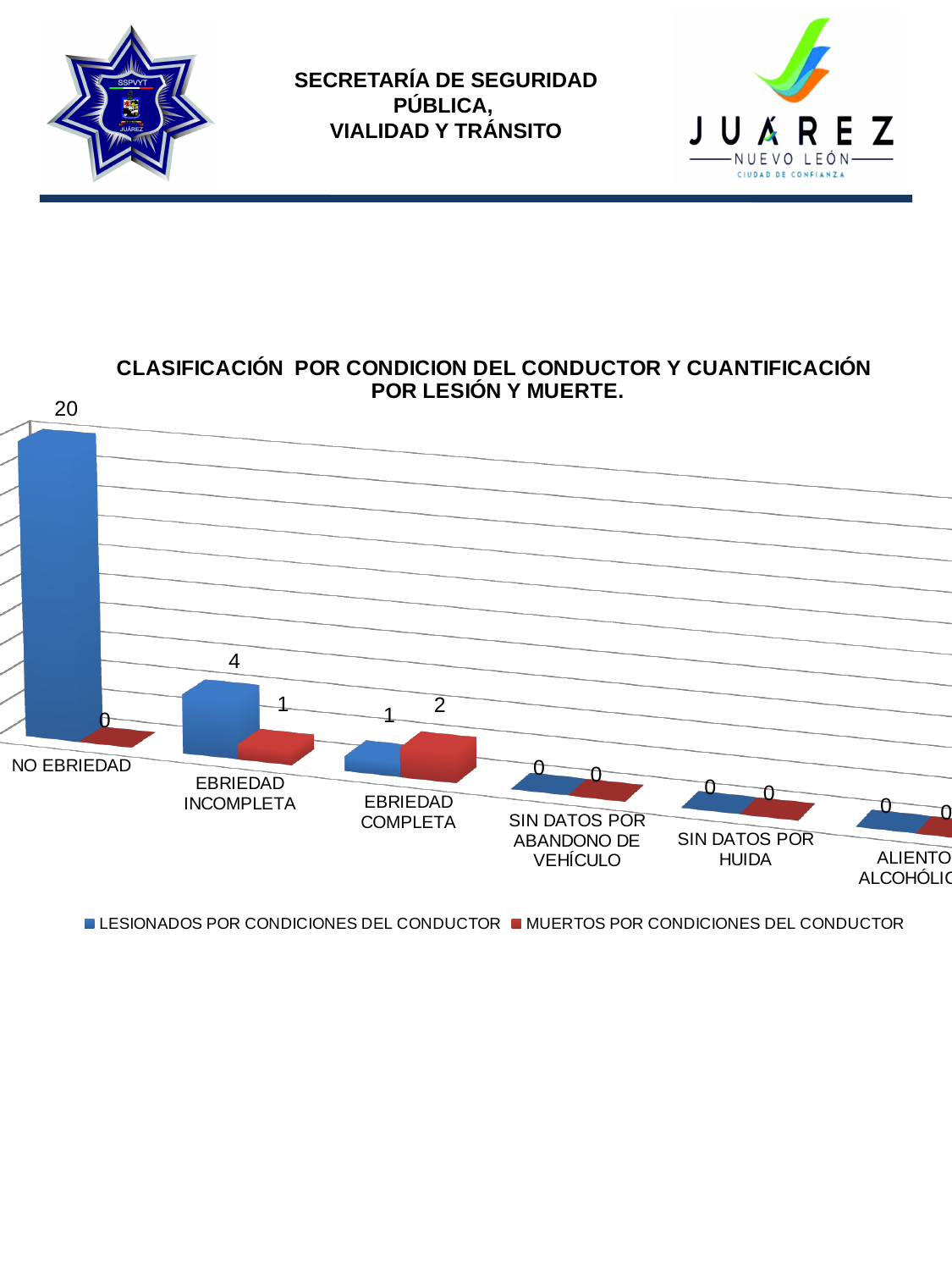
What is the value for MUERTOS POR CONDICIONES DEL CONDUCTOR in the EBRIEDAD COMPLETA category? 2 In the EBRIEDAD COMPLETA category, which series has the larger value, LESIONADOS or MUERTOS POR CONDICIONES DEL CONDUCTOR? MUERTOS POR CONDICIONES DEL CONDUCTOR What kind of chart is shown on the slide? Bar chart What is the value for LESIONADOS POR CONDICIONES DEL CONDUCTOR in the EBRIEDAD INCOMPLETA category? 4 How many series does the legend list? 2 What colour represents the MUERTOS POR CONDICIONES DEL CONDUCTOR series? Red In the EBRIEDAD INCOMPLETA category, which series has the larger value, LESIONADOS or MUERTOS POR CONDICIONES DEL CONDUCTOR? LESIONADOS POR CONDICIONES DEL CONDUCTOR What is the value for MUERTOS POR CONDICIONES DEL CONDUCTOR in the NO EBRIEDAD category? 0 What is the value for LESIONADOS POR CONDICIONES DEL CONDUCTOR in the NO EBRIEDAD category? 20 What is the difference between the LESIONADOS values for NO EBRIEDAD and EBRIEDAD INCOMPLETA? 16 Which category has the highest value for MUERTOS POR CONDICIONES DEL CONDUCTOR? EBRIEDAD COMPLETA Which category has the highest value for LESIONADOS POR CONDICIONES DEL CONDUCTOR? NO EBRIEDAD